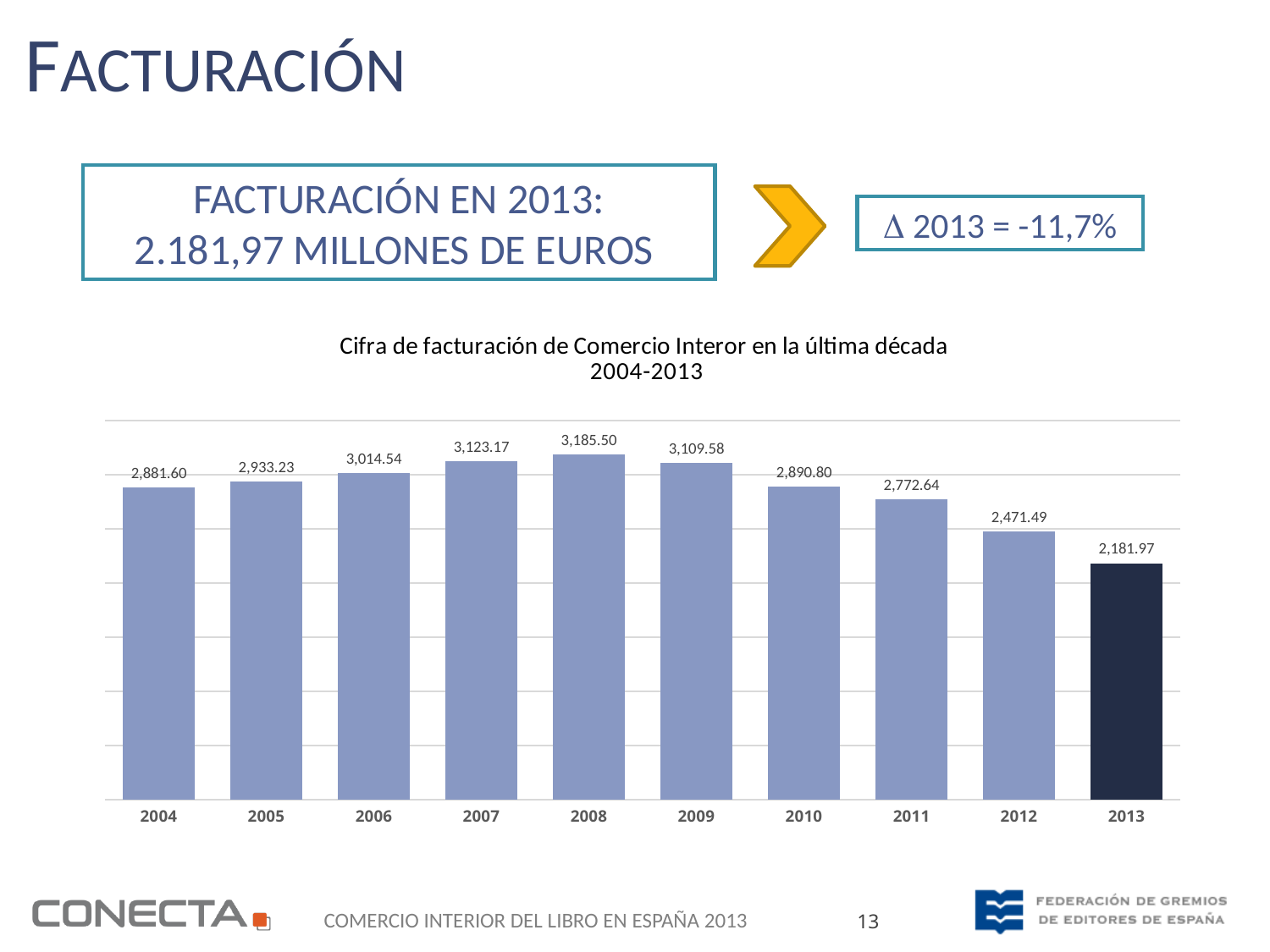
What is the value shown for 2004? 2,881.60 What is the value shown for 2013? 2,181.97 Which year has the highest value? 2008 Which year has the lowest value? 2013 What is the difference between the values for 2008 and 2004? 303.90 What is the difference between the values for 2012 and 2013? 289.52 What is the value shown for 2008? 3,185.50 What kind of chart is this? Bar chart Do the values rise or fall from 2008 to 2013? Fall Which is larger, the value for 2005 or the value for 2010? 2005 What is the value shown for 2011? 2,772.64 How many years are shown on the x axis? 10